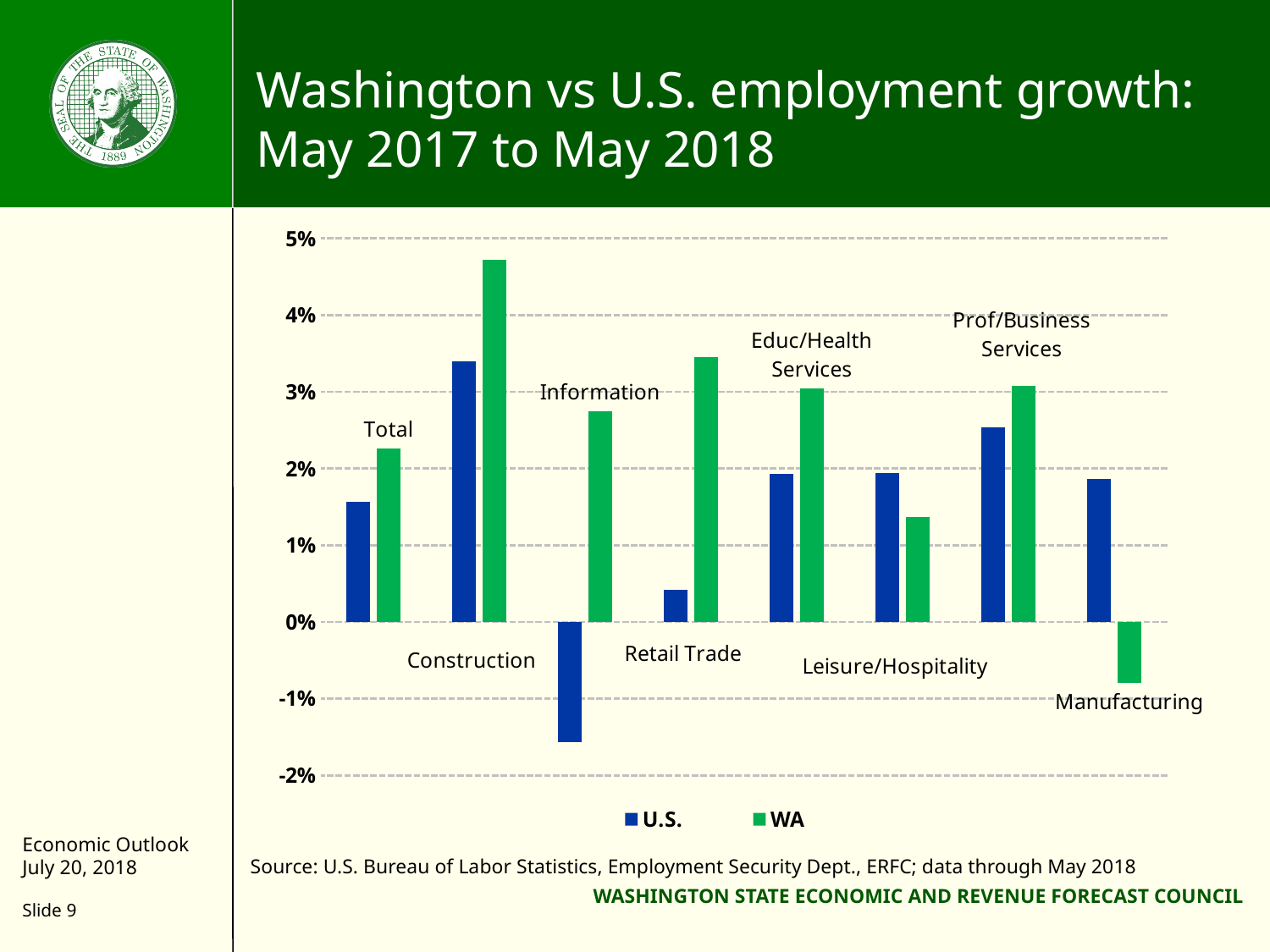
For Retail Trade, which is larger: the U.S. value or the WA value? WA Which category has the highest WA employment growth? Construction How many industry categories are plotted in the chart? 8 What colour represents the WA series in the chart? Green Which category has the lowest U.S. employment growth? Information Is the U.S. value for Retail Trade greater or less than 1%? less How many series does the legend list? 2 Is the U.S. value for Information greater or less than -1%? less Is the WA value for Manufacturing greater or less than 0%? less What kind of chart is shown on the slide? Bar chart For Leisure/Hospitality, which is larger: the U.S. value or the WA value? U.S.